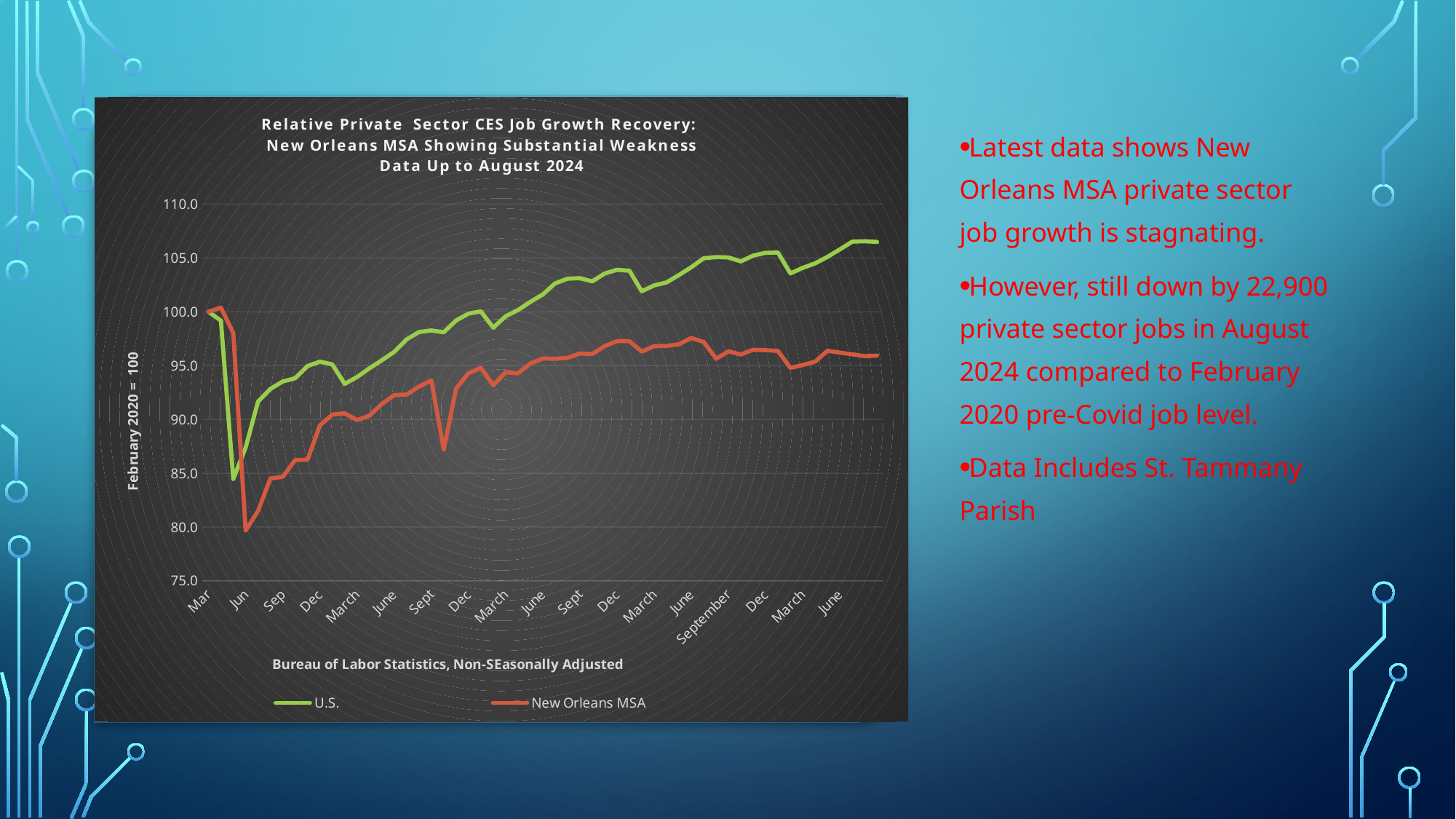
Is the lowest point of the New Orleans MSA series greater or less than 85? less Is the lowest point of the U.S. series greater or less than 90? less At the end of the chart (June 2024 onward), which series is higher, U.S. or New Orleans MSA? U.S. After the initial drop in 2020, do the values of the U.S. series generally rise or fall along the x axis? rise How many series does the chart's legend list? 2 What is the label on the chart's vertical axis? February 2020 = 100 What kind of chart is shown on the slide? Line chart Is the final value of the New Orleans MSA series greater or less than 100? less What are the two series named in the chart's legend? U.S. and New Orleans MSA Which series drops lower in the initial 2020 decline, U.S. or New Orleans MSA? New Orleans MSA What is the highest tick value shown on the chart's vertical axis? 110.0